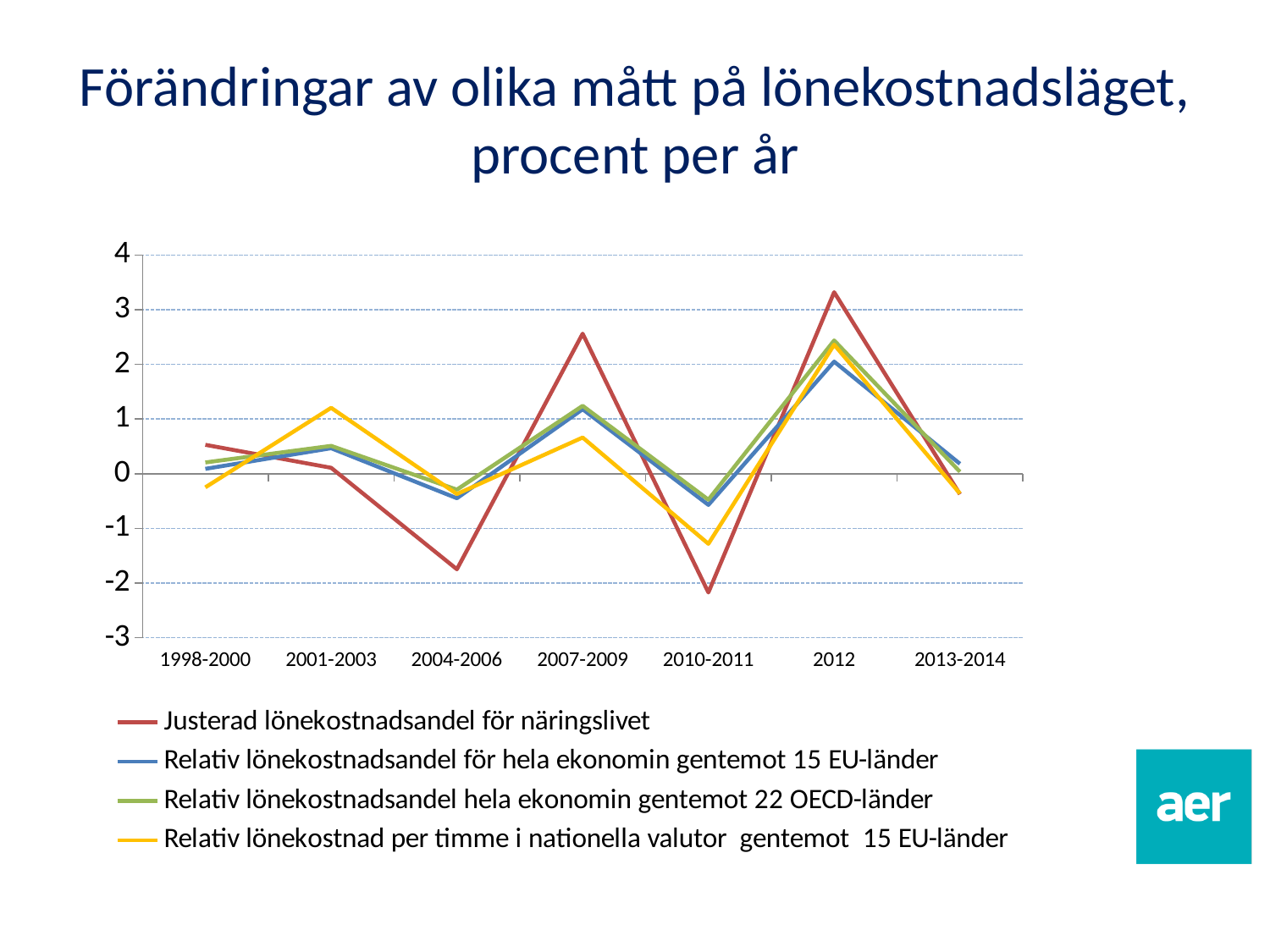
In which period does the series 'Relativ lönekostnad per timme i nationella valutor gentemot 15 EU-länder' reach its lowest value? 2010-2011 In 2007-2009, which series has the larger value: 'Justerad lönekostnadsandel för näringslivet' or 'Relativ lönekostnad per timme i nationella valutor gentemot 15 EU-länder'? Justerad lönekostnadsandel för näringslivet What kind of chart is shown on the slide? line chart What colour is the line for 'Justerad lönekostnadsandel för näringslivet'? red How many periods are shown on the x axis? 7 Is the value for 'Justerad lönekostnadsandel för näringslivet' in 2012 greater or less than 3? greater Is the value for 'Justerad lönekostnadsandel för näringslivet' in 2004-2006 greater or less than -1? less In which period does the series 'Justerad lönekostnadsandel för näringslivet' reach its highest value? 2012 Does the series 'Justerad lönekostnadsandel för näringslivet' rise or fall from 2012 to 2013-2014? fall How many series does the legend list? 4 In which period does the series 'Justerad lönekostnadsandel för näringslivet' reach its lowest value? 2010-2011 Is the value for 'Relativ lönekostnad per timme i nationella valutor gentemot 15 EU-länder' in 2001-2003 greater or less than 1? greater